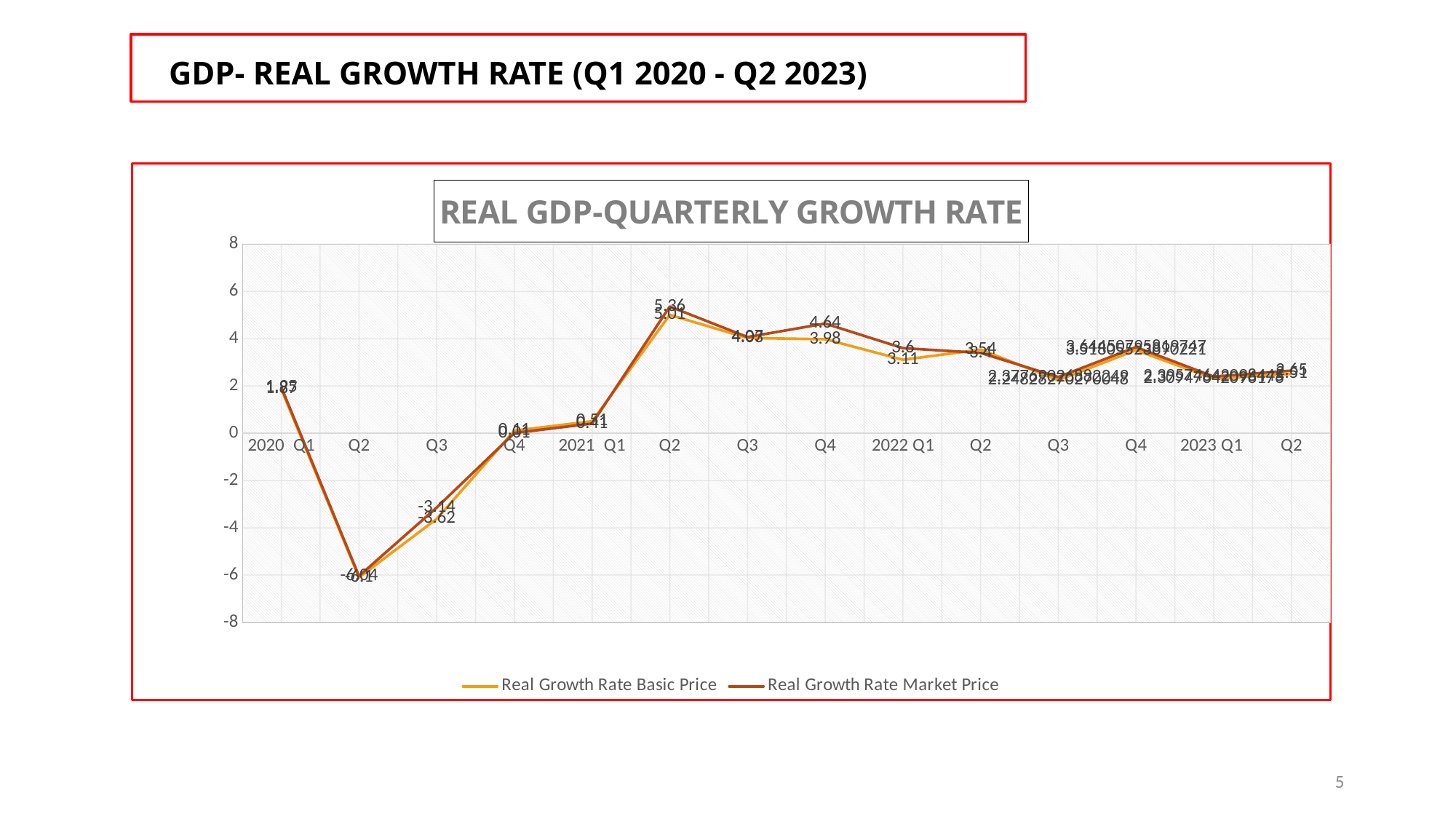
What is the Real Growth Rate Market Price value for 2021 Q4? 4.64 What kind of chart is shown on the slide? Line chart What is the difference between the Market Price and Basic Price growth rates in 2021 Q4? 0.66 Is the Real Growth Rate Basic Price value for 2020 Q2 greater or less than -4? less How many quarters are plotted along the x axis? 14 How many series does the legend list? 2 What is the Real Growth Rate Basic Price value for 2021 Q4? 3.98 In 2021 Q4, which series has the higher value, Real Growth Rate Basic Price or Real Growth Rate Market Price? Real Growth Rate Market Price What is the title of the chart? REAL GDP-QUARTERLY GROWTH RATE What is the Real Growth Rate Basic Price value for 2022 Q1? 3.11 In which quarter does the Real Growth Rate Basic Price reach its highest value? 2021 Q2 In which quarter does the Real Growth Rate Market Price reach its lowest value? 2020 Q2